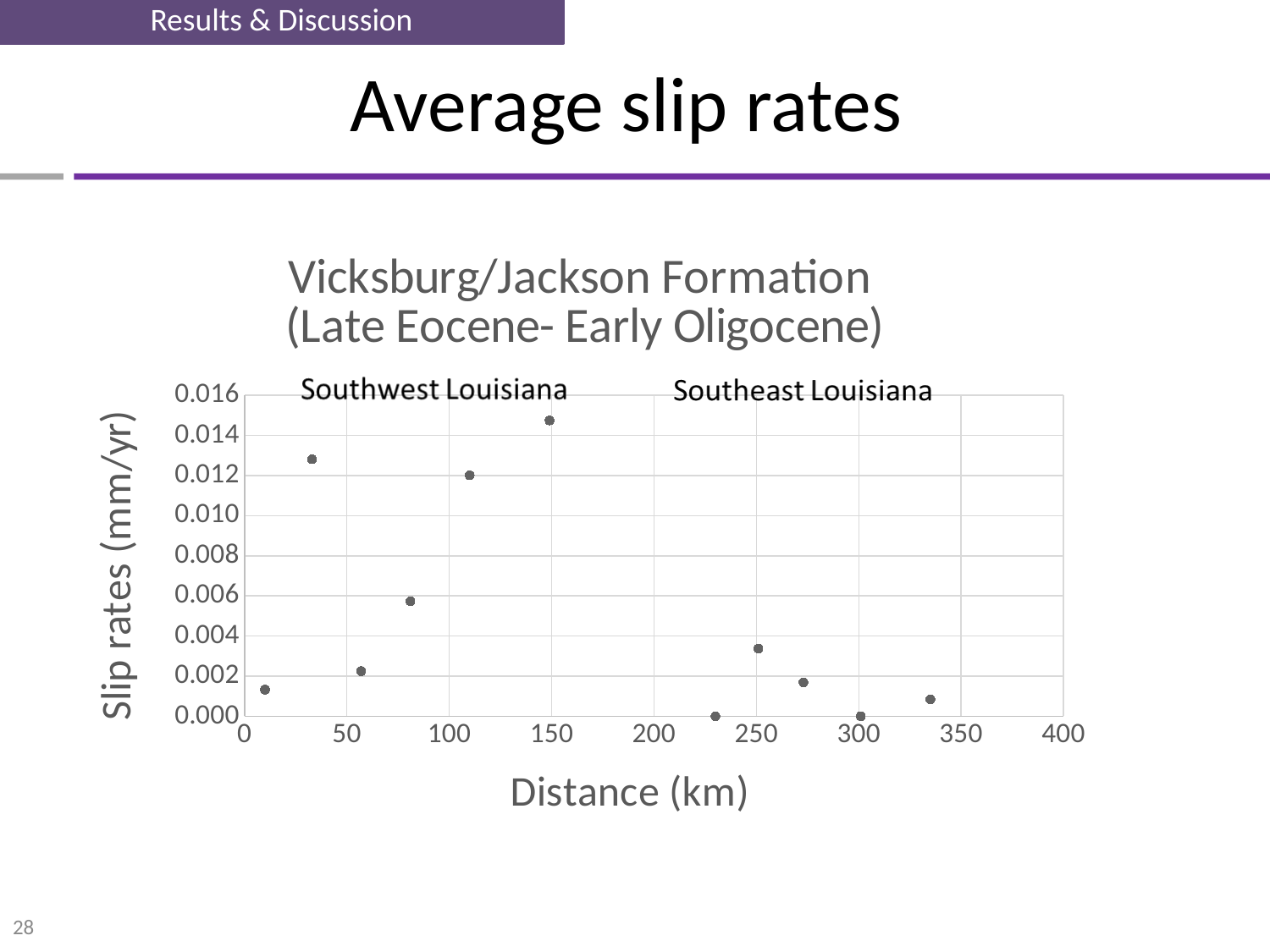
Which has the higher slip rate: the point near 80 km or the point near 110 km? the point near 110 km Is the slip rate for the point near 250 km greater or less than 0.004? less Which region's points generally have higher slip rates, Southwest Louisiana or Southeast Louisiana? Southwest Louisiana Which has the higher slip rate: the point near 150 km or the point near 250 km? the point near 150 km What is the label of the y axis? Slip rates (mm/yr) Is the slip rate for the point near 150 km greater or less than 0.014? greater Is the slip rate for the point near 10 km greater or less than 0.002? less What kind of chart is shown on the slide? scatter chart What is the title of the chart? Vicksburg/Jackson Formation (Late Eocene- Early Oligocene) How many data points are plotted in the chart? 11